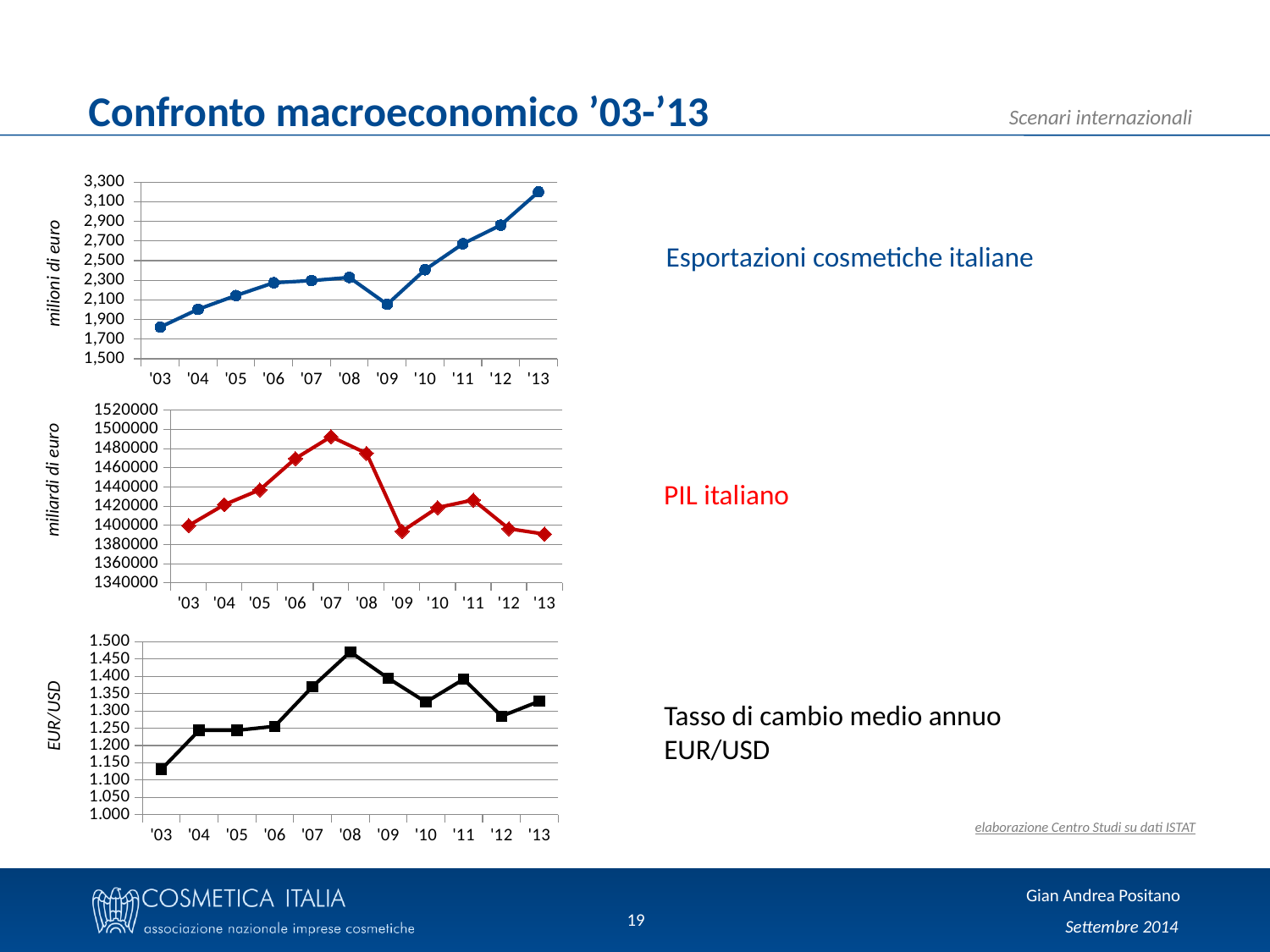
On the top chart (Esportazioni cosmetiche italiane), which year has the lowest value? '03 On the bottom chart (Tasso di cambio medio annuo EUR/USD), is the value for '03 greater or less than 1.150? less How many years are plotted on the top chart (Esportazioni cosmetiche italiane)? 11 On the top chart (Esportazioni cosmetiche italiane), is the value for '13 greater or less than 3,100? greater On the middle chart (PIL italiano), which year has the highest value? '07 On the bottom chart (Tasso di cambio medio annuo EUR/USD), which year has the highest value? '08 On the middle chart (PIL italiano), is the value for '08 larger or smaller than the value for '09? larger On the top chart (Esportazioni cosmetiche italiane), is the value for '03 greater or less than 1,900? less What is the y-axis label of the middle chart (PIL italiano)? miliardi di euro On the top chart (Esportazioni cosmetiche italiane), which year has the highest value? '13 What kind of chart is the top chart (Esportazioni cosmetiche italiane)? line chart On the top chart (Esportazioni cosmetiche italiane), do the values overall rise or fall from '03 to '13? rise